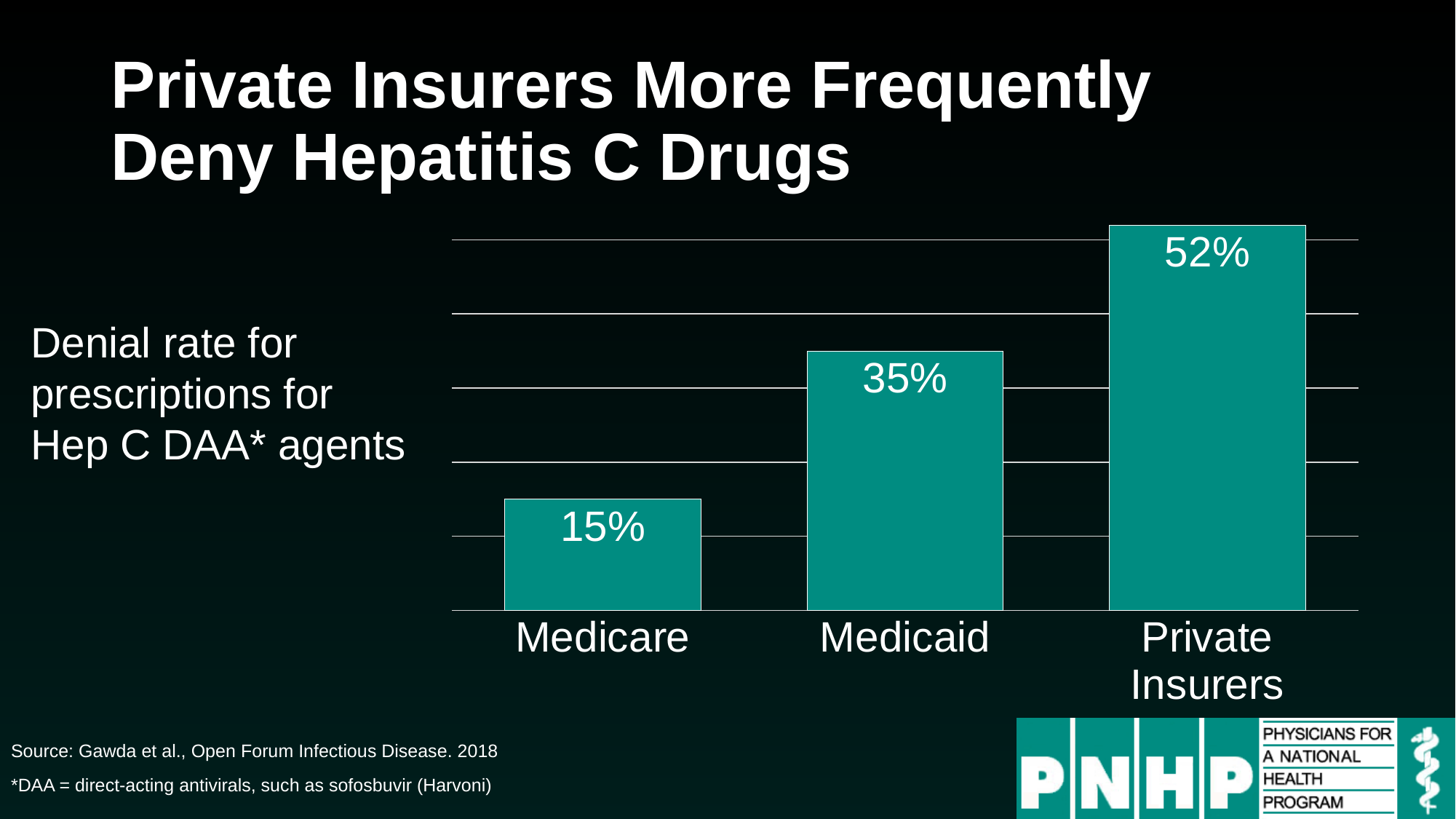
What is the title of the slide? Private Insurers More Frequently Deny Hepatitis C Drugs What kind of chart is shown on the slide? Bar chart What is the difference between the denial rates for Medicaid and Medicare? 20% Do the denial rates rise or fall from Medicare to Private Insurers along the x axis? Rise What is the denial rate for Medicare? 15% Which category has the lowest denial rate? Medicare What is the denial rate for Medicaid? 35% Which category has the highest denial rate? Private Insurers What is the difference between the denial rates for Private Insurers and Medicare? 37% Which has a higher denial rate, Medicaid or Medicare? Medicaid How many categories are shown in the chart? 3 What is the denial rate for Private Insurers? 52%